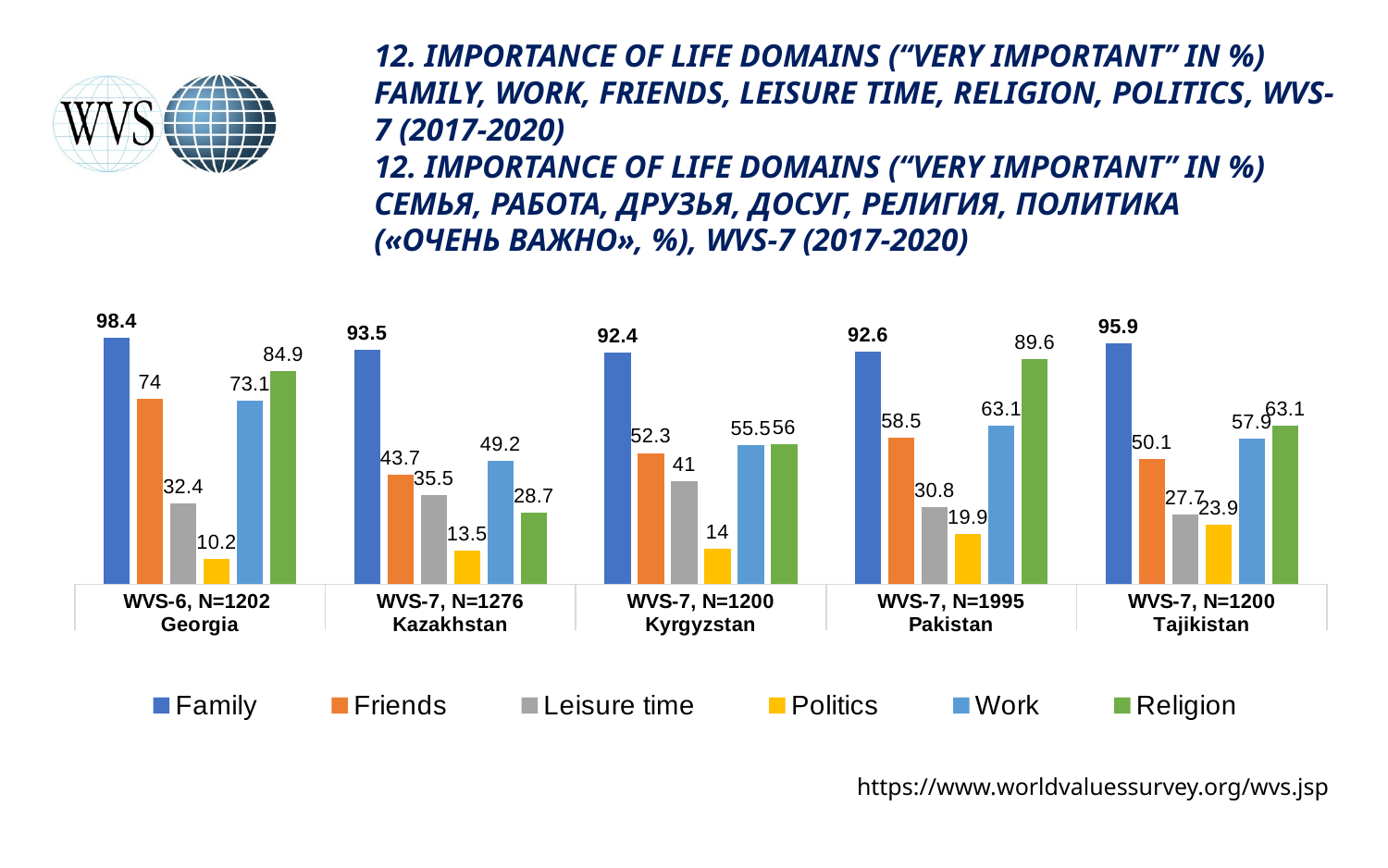
What kind of chart is shown on the slide? Bar chart What is the value for Religion in Pakistan? 89.6 Which country has the lowest value for Religion? Kazakhstan How many countries are shown on the x axis? 5 What is the value for Work in Tajikistan? 57.9 Which country has the highest value for Politics? Tajikistan Which is larger in Kyrgyzstan, the value for Friends or the value for Leisure time? Friends Which country has the highest value for Family? Georgia What is the value for Family in Georgia? 98.4 What is the difference between the Family and Religion values in Georgia? 13.5 How many series does the legend list? 6 What is the value for Politics in Kazakhstan? 13.5